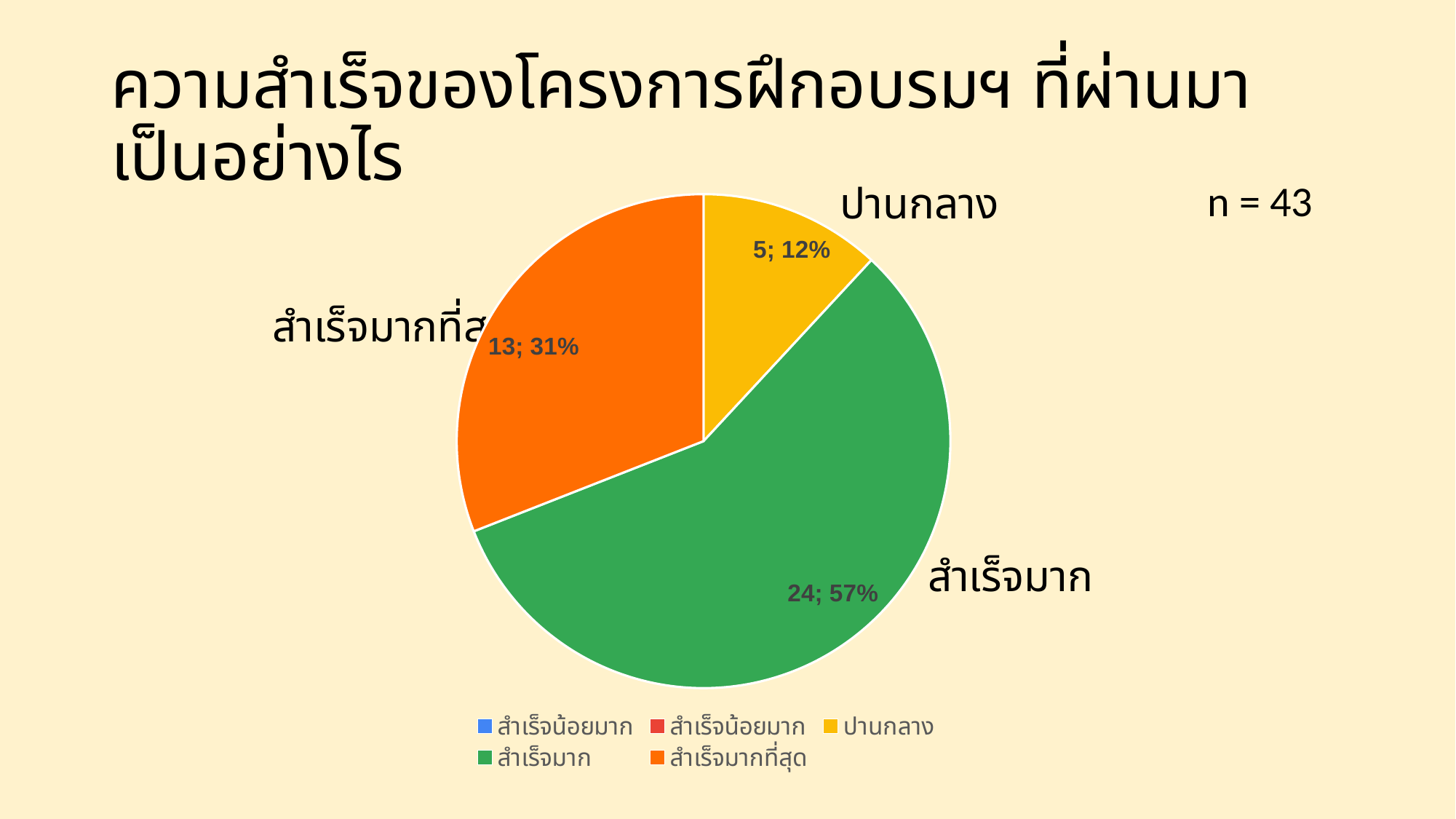
How many respondents are in the สำเร็จมากที่สุด slice? 13 What is the difference in respondent count between สำเร็จมาก and สำเร็จมากที่สุด? 11 How many slices with data labels are shown in the pie? 3 Which category has the largest slice of the pie? สำเร็จมาก Which slice is larger, สำเร็จมากที่สุด or ปานกลาง? สำเร็จมากที่สุด Which labelled slice of the pie is the smallest? ปานกลาง How many entries does the legend list? 5 What percentage of the pie is the สำเร็จมาก slice? 57% What sample size (n) is stated on the slide? n = 43 What percentage of the pie is the สำเร็จมากที่สุด slice? 31% What kind of chart is shown on the slide? Pie chart How many respondents are in the ปานกลาง slice? 5